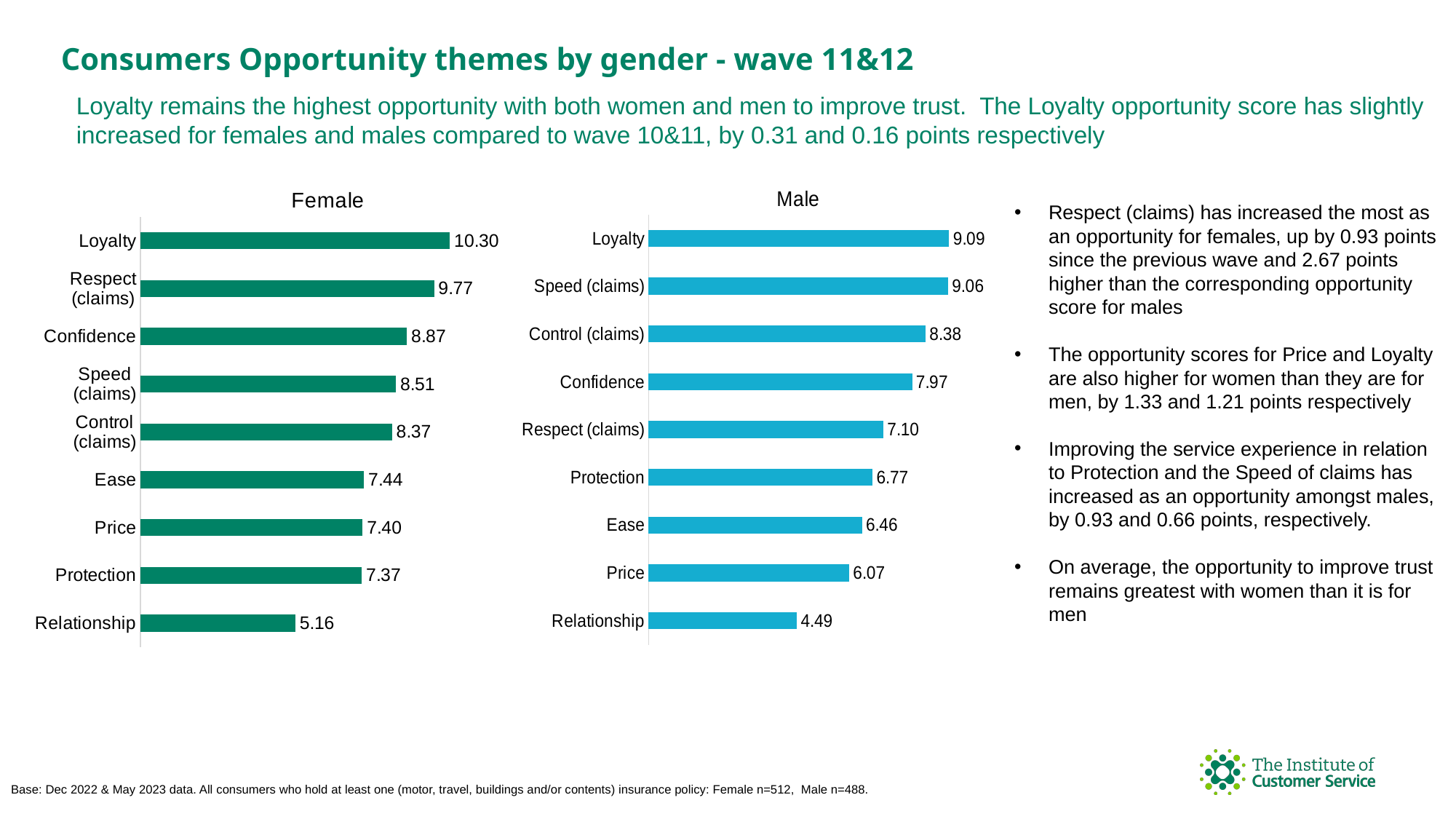
In the Male chart, which category has the lowest value? Relationship In the Female chart, what is the value for Loyalty? 10.30 What type of chart is the Female chart? Bar chart Which is larger: Price in the Female chart or Price in the Male chart? Price in the Female chart In the Male chart, what is the value for Speed (claims)? 9.06 In the Female chart, which category has the highest value? Loyalty In the Male chart, what is the difference between Loyalty and Relationship? 4.60 In the Female chart, what is the difference between Respect (claims) and Confidence? 0.90 In the Male chart, what is the value for Control (claims)? 8.38 In the Female chart, what is the value for Protection? 7.37 How many categories are shown in the Male chart? 9 What is the title of the chart on the right? Male